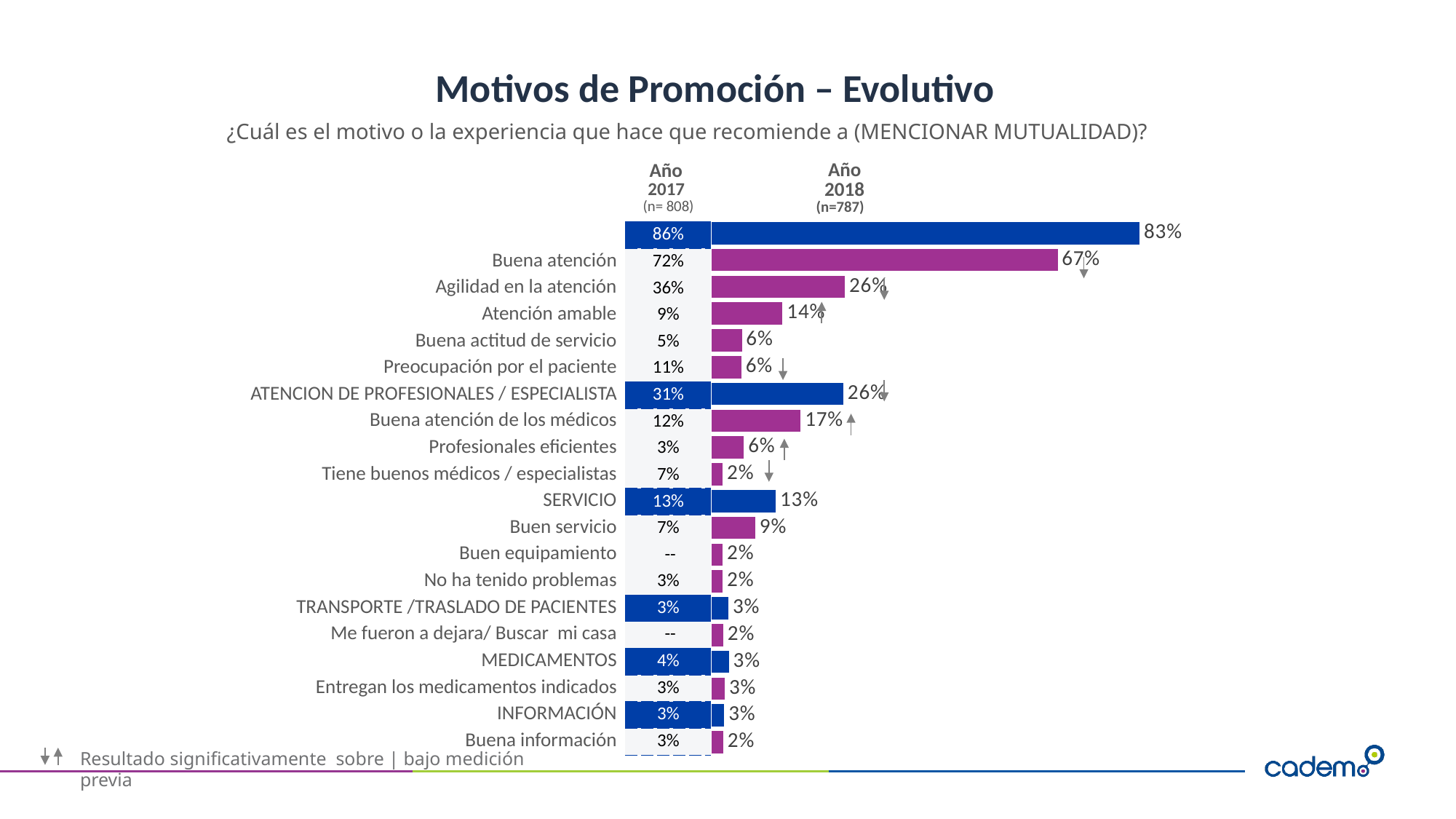
What is the 2018 value for "Buena atención"? 67% What is the 2018 value for "Atención amable"? 14% What is the 2017 value for "Preocupación por el paciente"? 11% By how many percentage points did "Agilidad en la atención" fall from 2017 to 2018? 10 percentage points In 2018, which is larger: "Buen servicio" or "Profesionales eficientes"? Buen servicio What is the 2017 value for "Agilidad en la atención"? 36% By how many percentage points did "Buena atención" fall from 2017 to 2018? 5 percentage points What is the 2018 value for "SERVICIO"? 13% What kind of chart is used to show the 2018 values? Bar chart What is the sample size (n) for Año 2018? n=787 For "Buena atención de los médicos", which year has the higher value, 2017 or 2018? 2018 What is shown as the 2017 value for "Buen equipamiento"? --